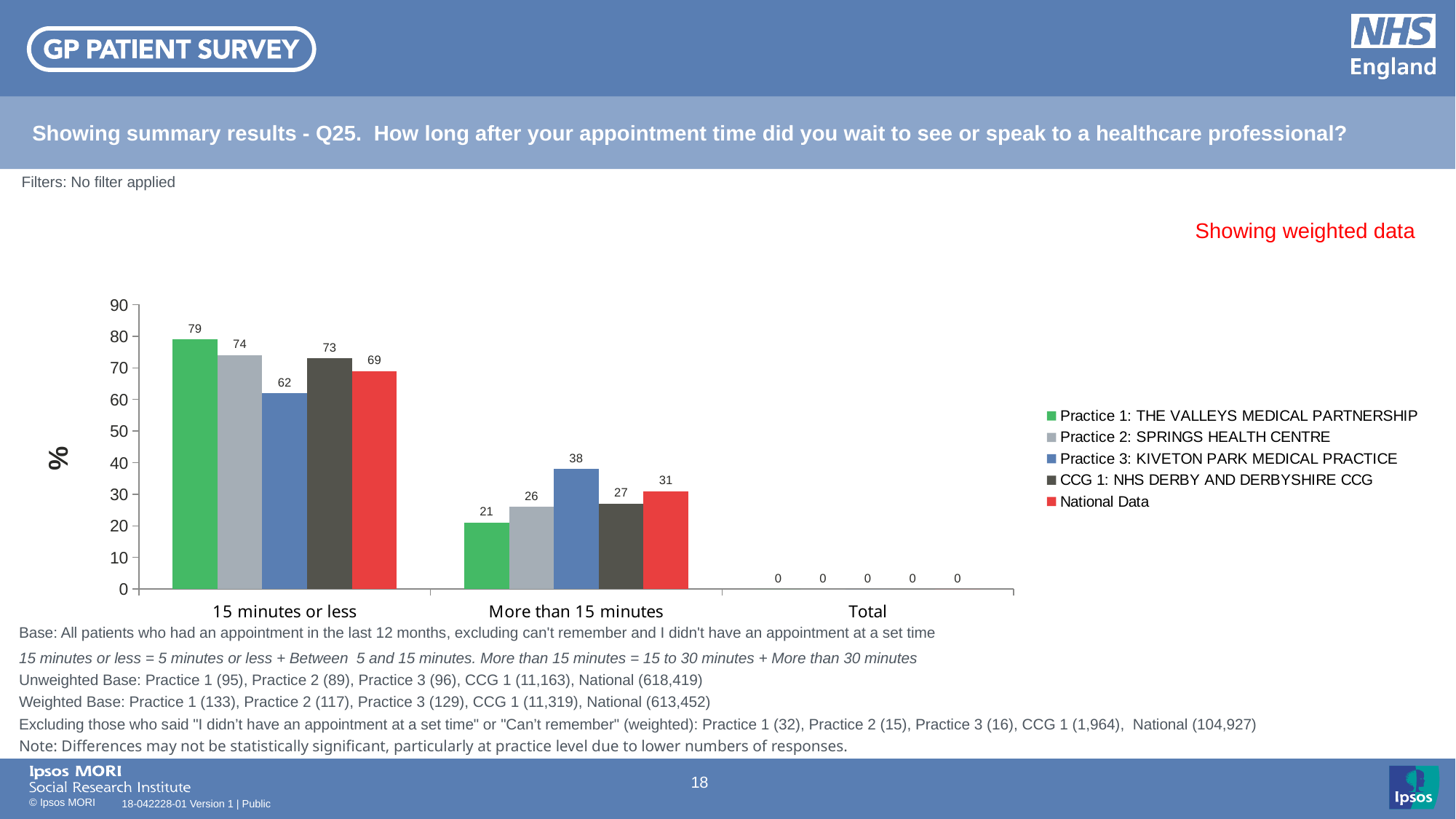
What is the value for Practice 3: KIVETON PARK MEDICAL PRACTICE in the '15 minutes or less' category? 62 How many categories are shown on the x axis? 3 What is the value for National Data in the 'More than 15 minutes' category? 31 What is the difference between Practice 1 and National Data in the '15 minutes or less' category? 10 Is the value for Practice 2: SPRINGS HEALTH CENTRE in the '15 minutes or less' category greater or less than 70? greater Which series has the lowest value in the '15 minutes or less' category? Practice 3: KIVETON PARK MEDICAL PRACTICE What kind of chart is shown on the slide? Bar chart Which is larger in the 'More than 15 minutes' category: CCG 1: NHS DERBY AND DERBYSHIRE CCG or Practice 2: SPRINGS HEALTH CENTRE? CCG 1: NHS DERBY AND DERBYSHIRE CCG What is the value shown for every series in the 'Total' category? 0 How many series does the legend list? 5 What is the value for Practice 1: THE VALLEYS MEDICAL PARTNERSHIP in the '15 minutes or less' category? 79 Which series has the highest value in the 'More than 15 minutes' category? Practice 3: KIVETON PARK MEDICAL PRACTICE